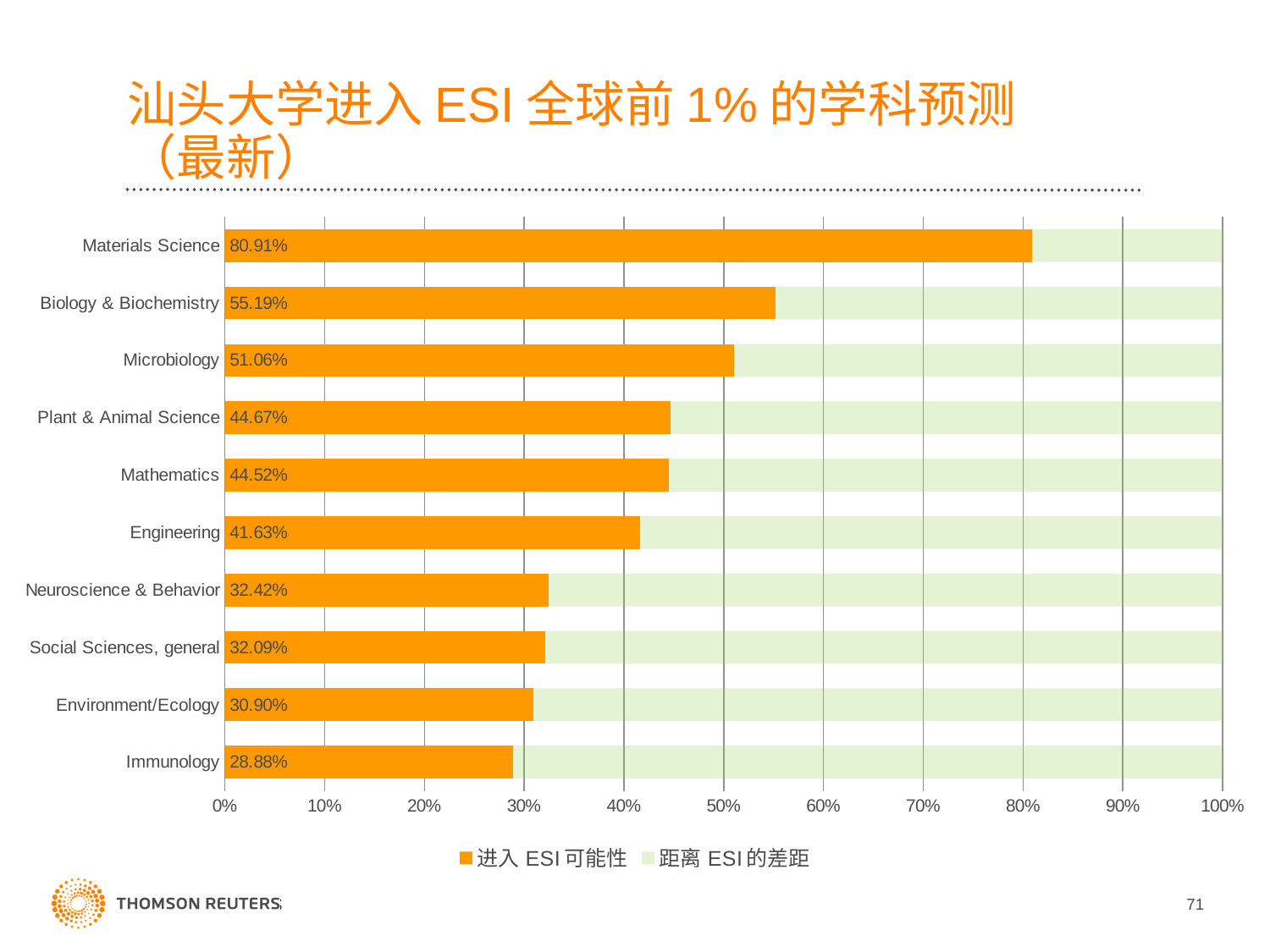
Which discipline has the highest 进入 ESI 可能性 value? Materials Science How many disciplines are shown on the chart? 10 Which has a larger 进入 ESI 可能性 value, Microbiology or Engineering? Microbiology What is the 进入 ESI 可能性 value for Mathematics? 44.52% What is the 进入 ESI 可能性 value for Materials Science? 80.91% What is the 进入 ESI 可能性 value for Immunology? 28.88% What kind of chart is shown on the slide? Stacked horizontal bar chart How many series does the legend list? 2 Which discipline has the lowest 进入 ESI 可能性 value? Immunology Is the 进入 ESI 可能性 value for Environment/Ecology greater or less than 40%? less Which colour represents 进入 ESI 可能性 in the chart? Orange What is the difference between the 进入 ESI 可能性 values for Materials Science and Biology & Biochemistry? 25.72%